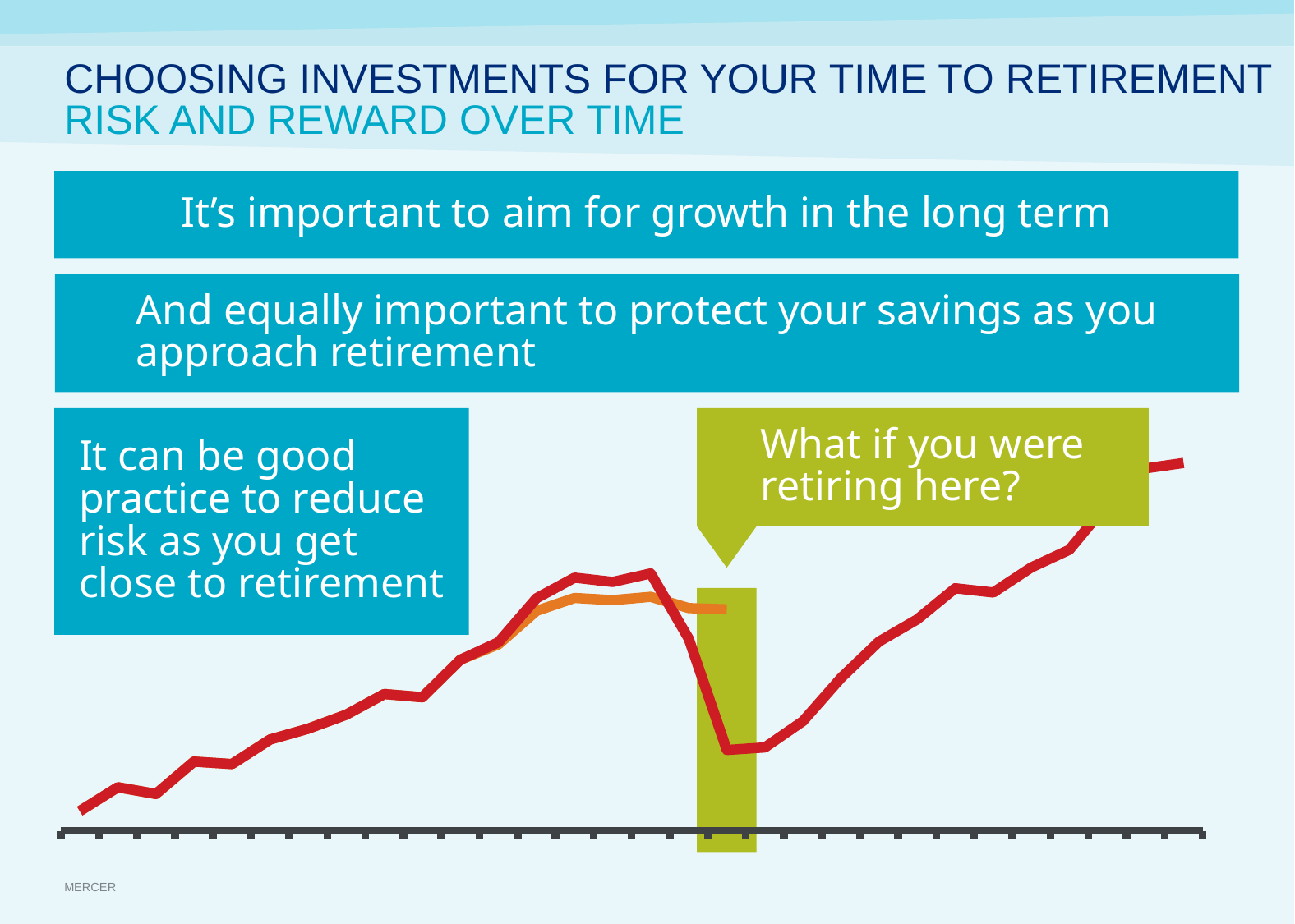
What colour is the shorter line that branches off the main line before the dip? orange Within the green highlighted band, does the red line rise or fall? fall Where the orange line ends, is the red line above or below the orange line? below What kind of chart is shown on the slide? line chart What does the green callout above the highlighted band say? What if you were retiring here? After the green highlighted band, does the red line rise or fall towards the right edge of the chart? rise Overall, does the red line rise or fall from the left of the chart to the right? rise Is the red line's value at the right end of the chart higher or lower than its value at the left end? higher